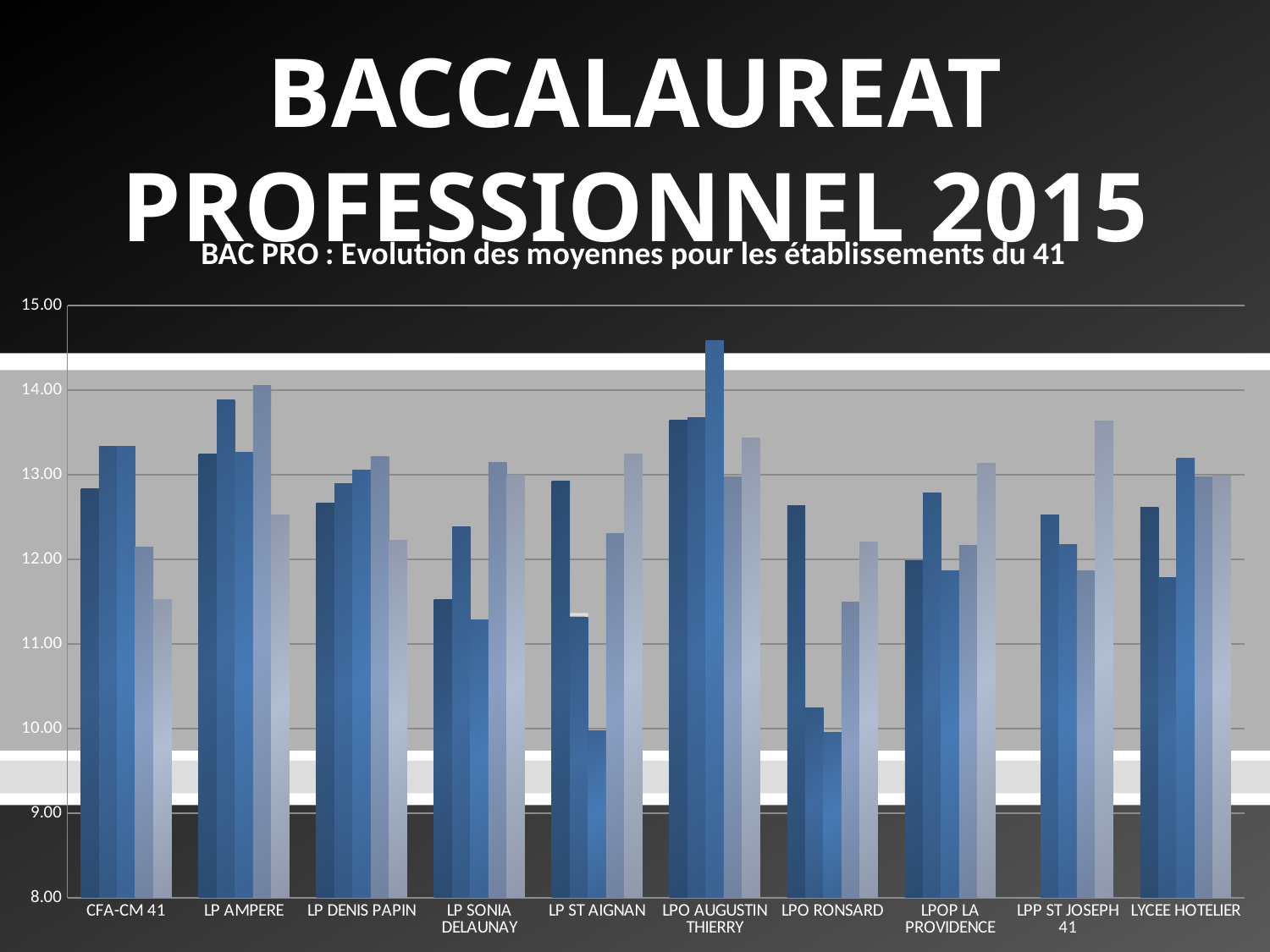
Which is taller: the tallest bar for LPO AUGUSTIN THIERRY or the tallest bar for LYCEE HOTELIER? LPO AUGUSTIN THIERRY What are the lowest and highest values shown on the y axis? 8.00 and 15.00 Is the tallest bar for LPO AUGUSTIN THIERRY greater or less than 14.00? greater How many establishments (categories) are shown on the x axis of the chart? 10 Is the shortest bar for LPO RONSARD greater or less than 11.00? less What kind of chart is shown on the slide? bar chart Is the shortest bar for LP SONIA DELAUNAY greater or less than 12.00? less How many bars are plotted for each establishment? 5 (except LPP ST JOSEPH 41, which has only 4) Which establishment has the tallest bar in the whole chart? LPO AUGUSTIN THIERRY What is the title of the chart? BAC PRO : Evolution des moyennes pour les établissements du 41